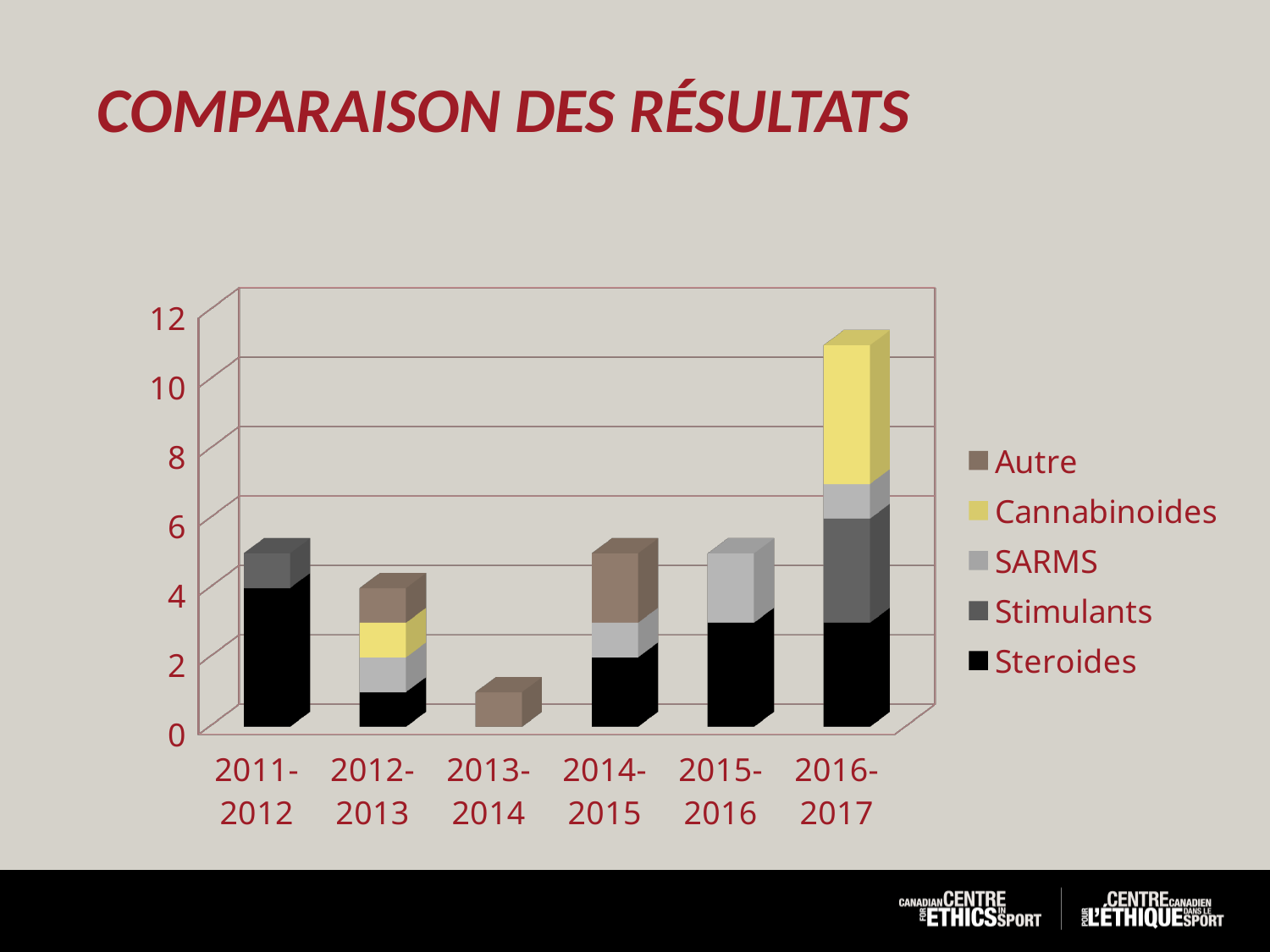
Which year has the highest total bar? 2016-2017 Which total is larger, 2016-2017 or 2012-2013? 2016-2017 Which total is larger, 2011-2012 or 2013-2014? 2011-2012 Is the total for 2016-2017 greater or less than 8? greater What is the title of the slide? COMPARAISON DES RÉSULTATS Is the total for 2012-2013 greater or less than 6? less How many series does the legend list? 5 How many year categories are shown on the x axis? 6 Which year has the lowest total bar? 2013-2014 Which series is shown in yellow in the legend? Cannabinoides Is the total for 2013-2014 greater or less than 2? less What kind of chart is shown on the slide? stacked bar chart